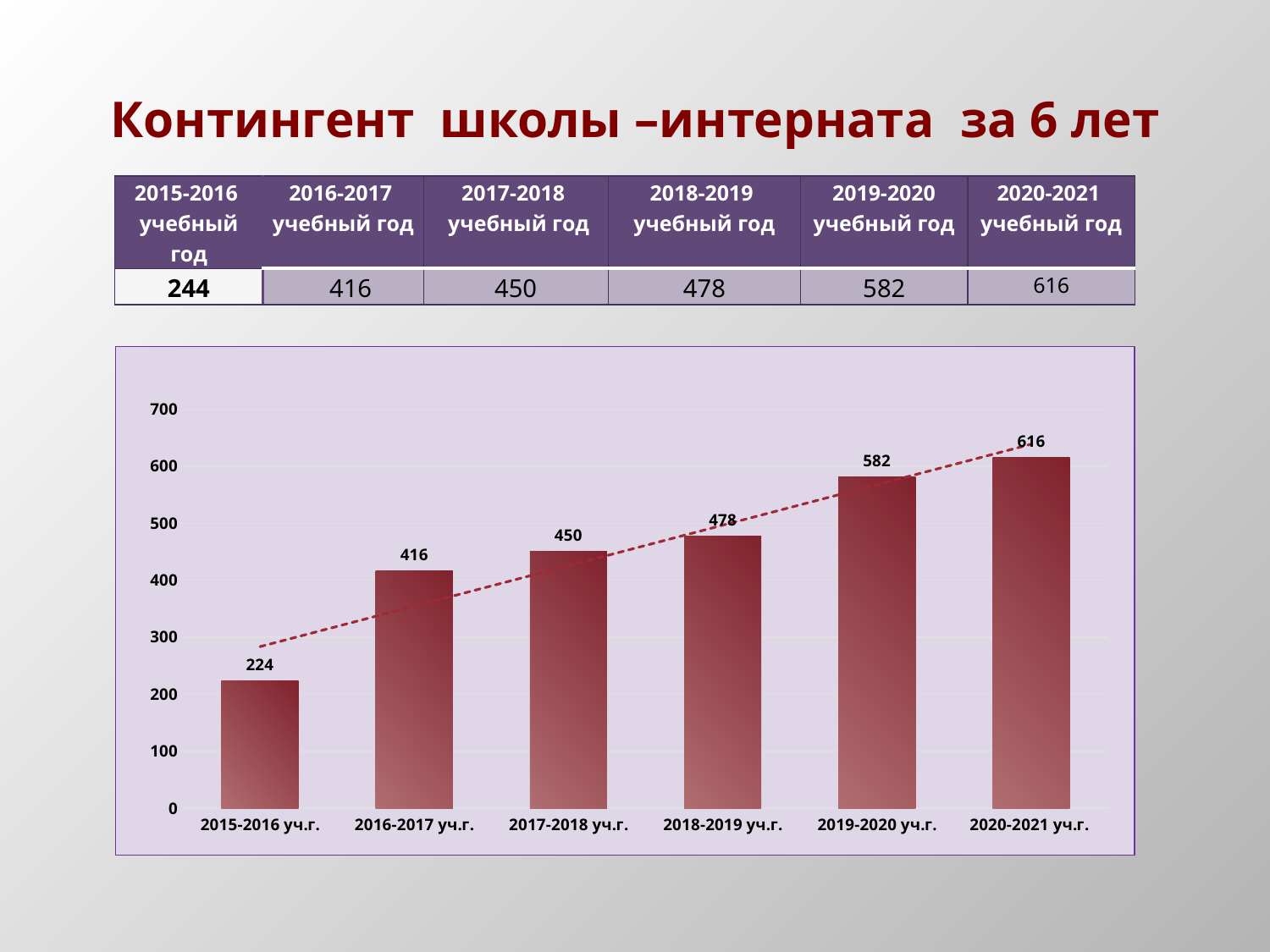
Which academic year has the highest bar in the chart? 2020-2021 уч.г. Is the value for 2019-2020 уч.г. greater or less than 500? greater What is the difference between the chart values for 2017-2018 уч.г. and 2016-2017 уч.г.? 34 What is the data label on the bar for 2015-2016 уч.г. in the chart? 224 What kind of chart is shown on the slide? bar chart Do the values in the chart rise or fall from 2015-2016 уч.г. to 2020-2021 уч.г.? rise What is the value shown on the chart for 2016-2017 уч.г.? 416 What is the value shown on the chart for 2019-2020 уч.г.? 582 How many academic years are shown as bars in the chart? 6 Which is larger in the chart: the value for 2018-2019 уч.г. or the value for 2017-2018 уч.г.? 2018-2019 уч.г. What is the difference between the chart values for 2020-2021 уч.г. and 2019-2020 уч.г.? 34 Which academic year has the lowest bar in the chart? 2015-2016 уч.г.